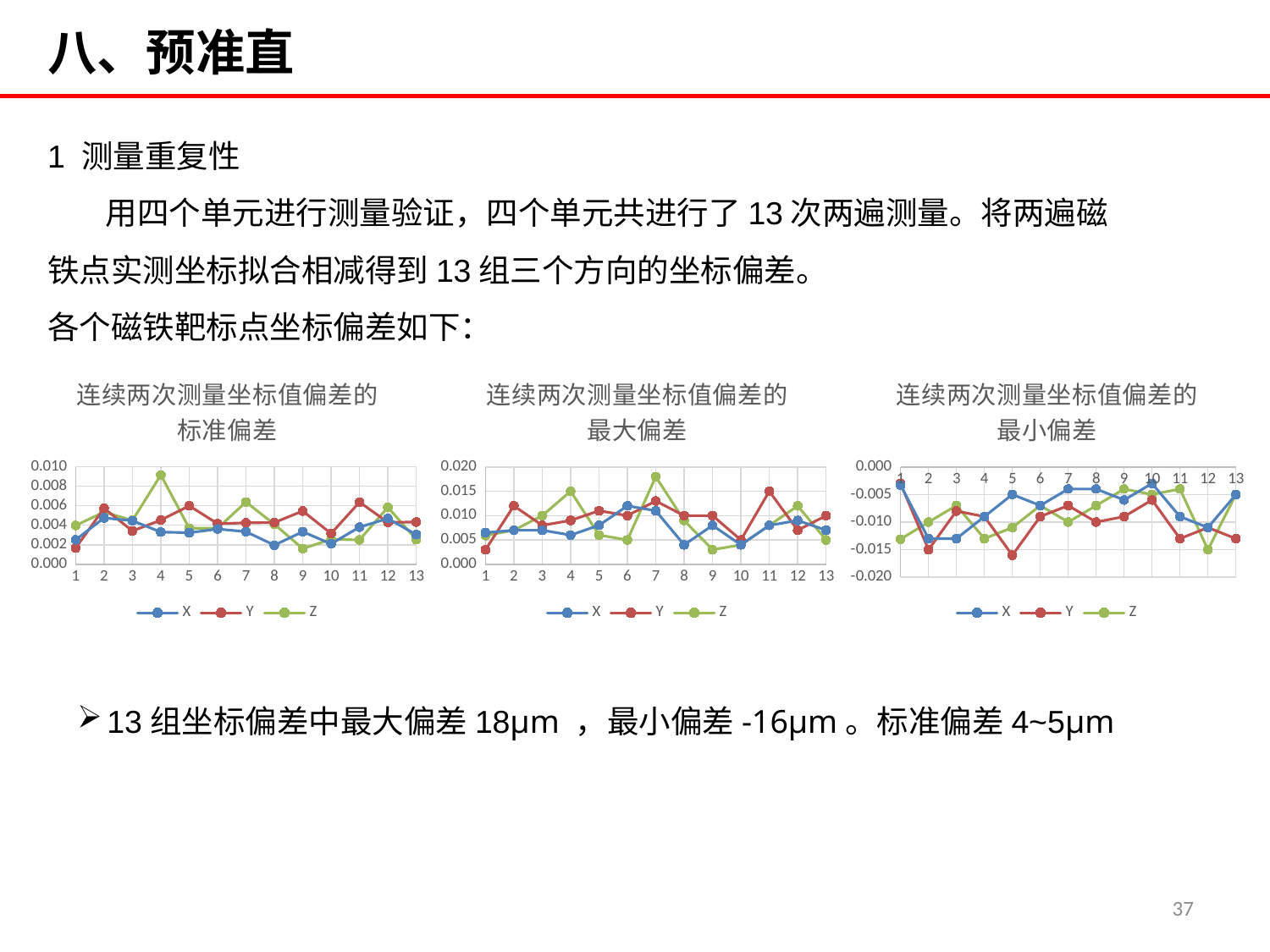
What are the legend entries of the leftmost chart (连续两次测量坐标值偏差的标准偏差)? X, Y, Z In the leftmost chart (连续两次测量坐标值偏差的标准偏差), at which point does the Z series reach its highest value? 4 In the middle chart (连续两次测量坐标值偏差的最大偏差), is the Y value at point 1 greater or less than 0.005? less In the middle chart (连续两次测量坐标值偏差的最大偏差), is the Z value at point 7 greater or less than 0.015? greater In the middle chart (连续两次测量坐标值偏差的最大偏差), at point 7, which series has the larger value, X or Z? Z In the middle chart (连续两次测量坐标值偏差的最大偏差), at which point does the Z series reach its highest value? 7 What kind of chart is the leftmost chart titled 连续两次测量坐标值偏差的标准偏差? line chart How many points are plotted along the x axis of the rightmost chart (连续两次测量坐标值偏差的最小偏差)? 13 What is the title of the rightmost chart on the slide? 连续两次测量坐标值偏差的最小偏差 In the leftmost chart (连续两次测量坐标值偏差的标准偏差), is the Z value at point 4 greater or less than 0.008? greater How many series does the legend of the middle chart (连续两次测量坐标值偏差的最大偏差) list? 3